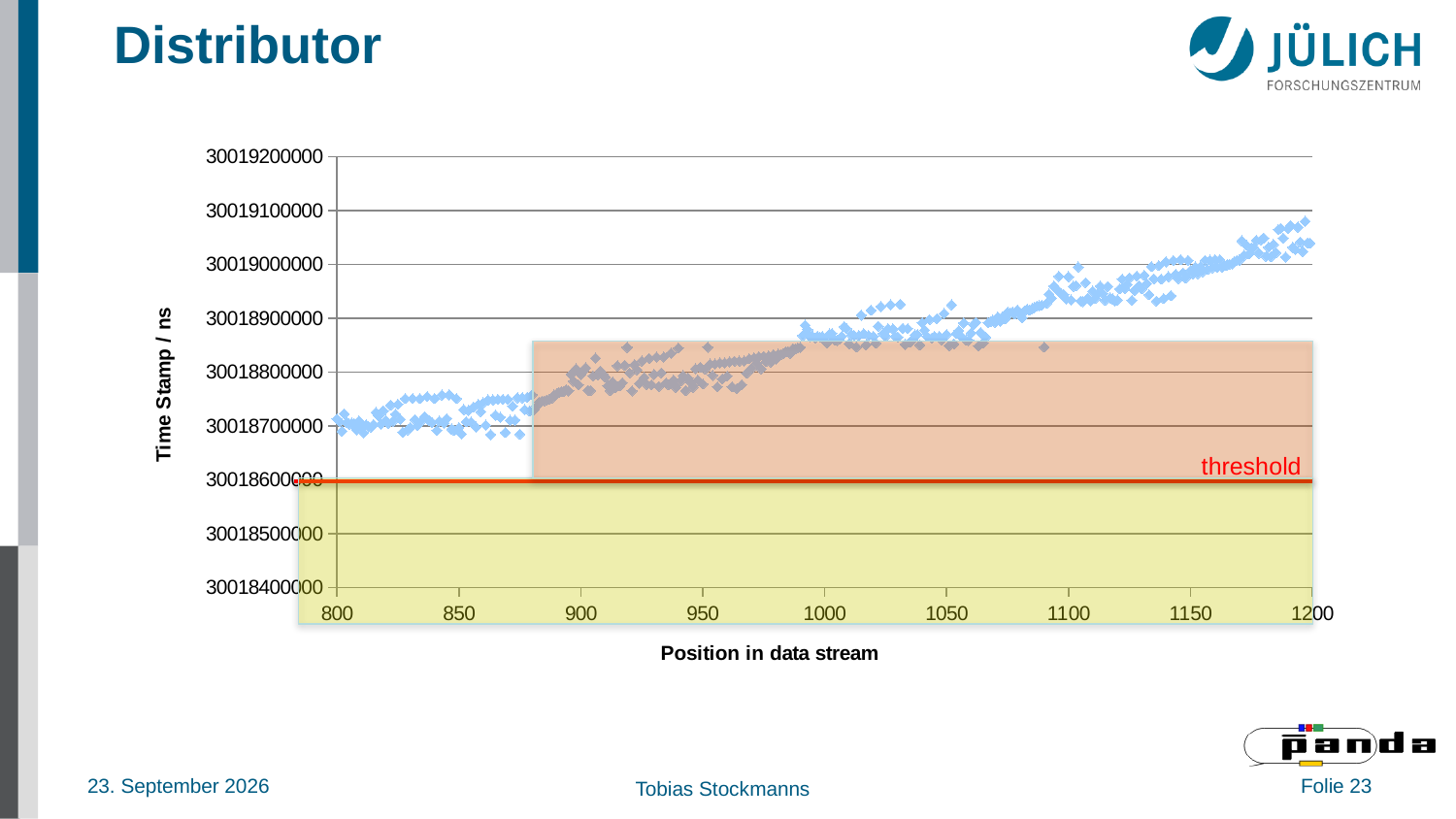
Is the time stamp value at position 1000 greater or less than 30018800000? greater Is the time stamp value at position 1200 greater or less than 30019000000? greater Are the plotted points above or below the threshold line? above Is the time stamp value at position 1100 greater or less than 30018800000? greater What is the title of the x axis? Position in data stream What is the title of the y axis? Time Stamp / ns What is the highest value shown on the x axis? 1200 Do the plotted time stamp values rise or fall as the position in the data stream increases? rise At what y-axis value is the red line labelled "threshold" drawn? 30018600000 Which position has the larger time stamp value, 800 or 1200? 1200 What kind of chart is shown on the slide? scatter chart